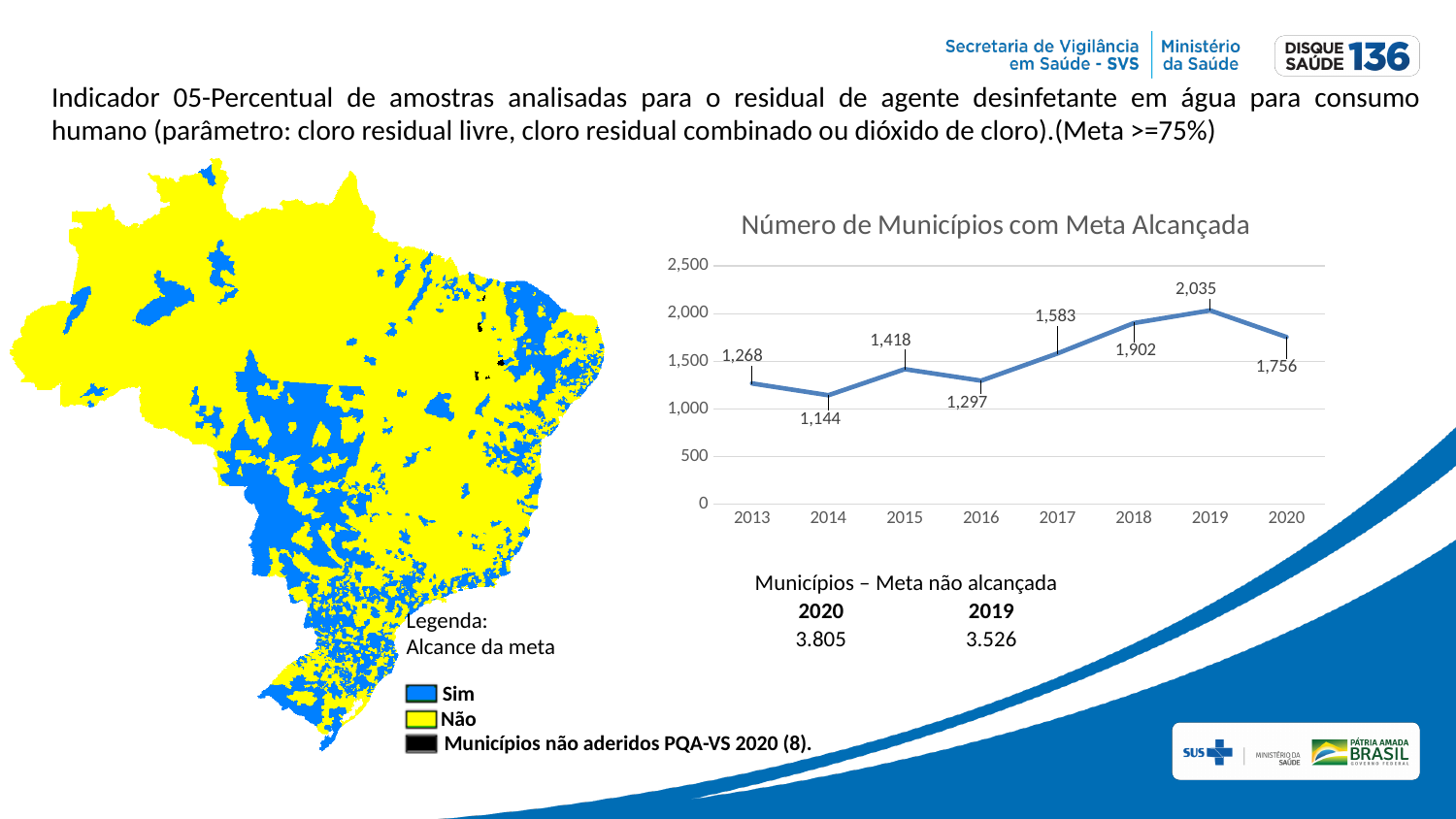
Does the value in the chart rise or fall from 2016 to 2019? rise Which year has the larger value in the chart, 2015 or 2016? 2015 How many years are plotted on the x axis of the chart? 8 What is the difference between the values for 2019 and 2020 in the chart? 279 Is the value for 2017 in the chart greater or less than 1,500? greater Which year has the lowest value in the chart? 2014 What is the value for 2013 in the chart? 1,268 What kind of chart is used to show the number of municipalities that reached the target? line chart What is the value for 2018 in the chart? 1,902 What is the title of the line chart on the slide? Número de Municípios com Meta Alcançada Which year has the highest value in the chart? 2019 What is the value for 2020 in the chart? 1,756